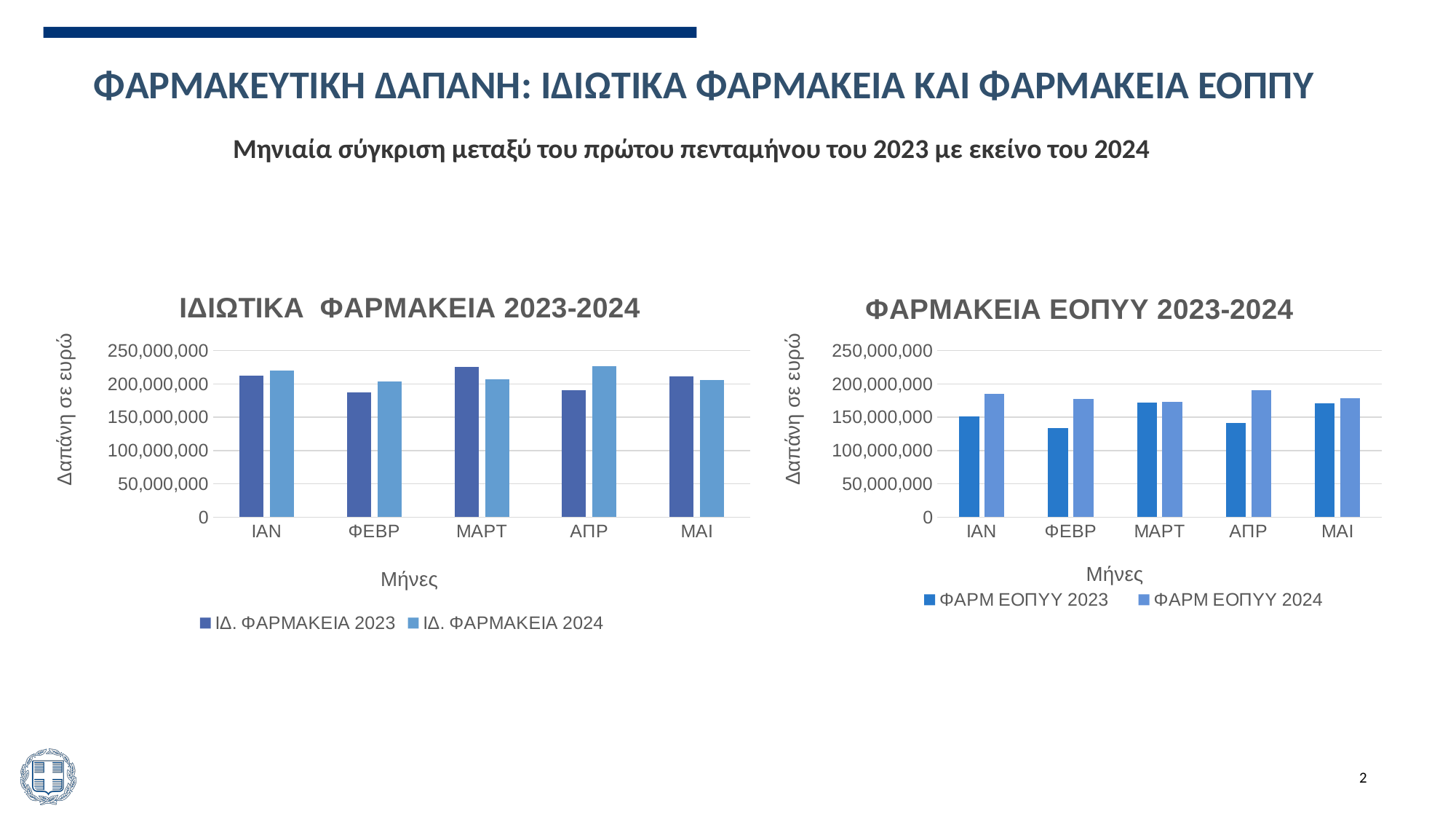
In the ΦΑΡΜΑΚΕΙΑ ΕΟΠΥΥ 2023-2024 chart, is the value for ΦΑΡΜ ΕΟΠΥΥ 2023 in ΑΠΡ greater or less than 150,000,000? less In the ΦΑΡΜΑΚΕΙΑ ΕΟΠΥΥ 2023-2024 chart, which is larger for ΦΕΒΡ: ΦΑΡΜ ΕΟΠΥΥ 2023 or ΦΑΡΜ ΕΟΠΥΥ 2024? ΦΑΡΜ ΕΟΠΥΥ 2024 What is the y-axis label of the ΦΑΡΜΑΚΕΙΑ ΕΟΠΥΥ 2023-2024 chart? Δαπάνη σε ευρώ In the ΙΔΙΩΤΙΚΑ ΦΑΡΜΑΚΕΙΑ 2023-2024 chart, is the value for ΙΔ. ΦΑΡΜΑΚΕΙΑ 2023 in ΦΕΒΡ greater or less than 200,000,000? less What are the two legend entries of the ΙΔΙΩΤΙΚΑ ΦΑΡΜΑΚΕΙΑ 2023-2024 chart? ΙΔ. ΦΑΡΜΑΚΕΙΑ 2023 and ΙΔ. ΦΑΡΜΑΚΕΙΑ 2024 What kind of chart is the ΙΔΙΩΤΙΚΑ ΦΑΡΜΑΚΕΙΑ 2023-2024 chart? Bar chart In the ΦΑΡΜΑΚΕΙΑ ΕΟΠΥΥ 2023-2024 chart, is the value for ΦΑΡΜ ΕΟΠΥΥ 2024 in ΙΑΝ greater or less than 150,000,000? greater In the ΙΔΙΩΤΙΚΑ ΦΑΡΜΑΚΕΙΑ 2023-2024 chart, which month has the highest value for ΙΔ. ΦΑΡΜΑΚΕΙΑ 2023? ΜΑΡΤ How many months are shown on the x axis of the ΙΔΙΩΤΙΚΑ ΦΑΡΜΑΚΕΙΑ 2023-2024 chart? 5 In the ΙΔΙΩΤΙΚΑ ΦΑΡΜΑΚΕΙΑ 2023-2024 chart, which is larger for ΑΠΡ: ΙΔ. ΦΑΡΜΑΚΕΙΑ 2023 or ΙΔ. ΦΑΡΜΑΚΕΙΑ 2024? ΙΔ. ΦΑΡΜΑΚΕΙΑ 2024 In the ΦΑΡΜΑΚΕΙΑ ΕΟΠΥΥ 2023-2024 chart, which month has the lowest value for ΦΑΡΜ ΕΟΠΥΥ 2023? ΦΕΒΡ How many series does the legend of the ΦΑΡΜΑΚΕΙΑ ΕΟΠΥΥ 2023-2024 chart list? 2